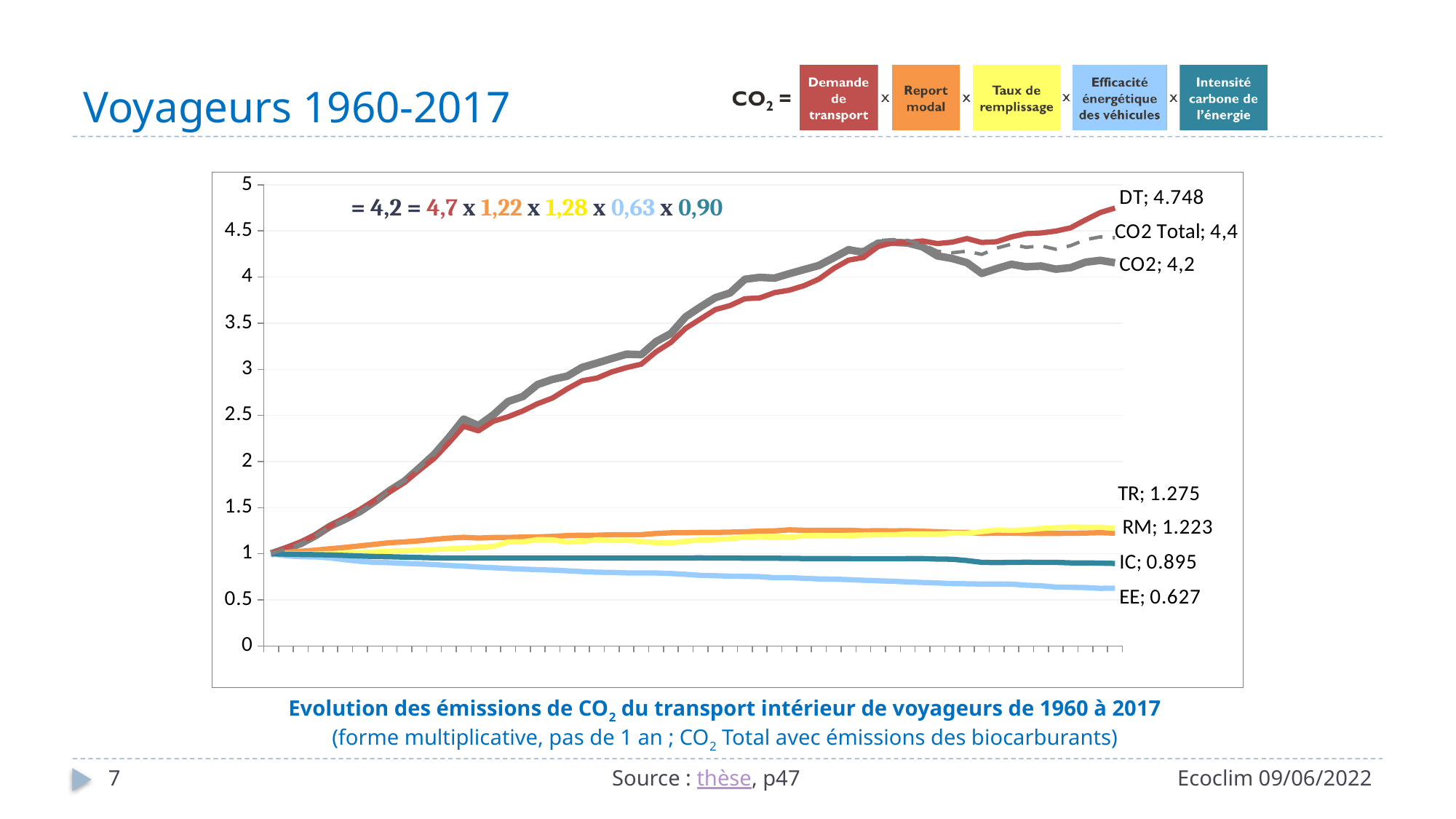
What is the final value shown for the IC series? 0.895 Which has a larger final value, IC or EE? IC Does the EE series rise or fall from 1960 to 2017? fall Is the final value of the CO2 series greater or less than 4? greater Which series has the lowest final value? EE What is the final value shown for the DT series? 4.748 What is the final value shown for the EE series? 0.627 What is the final value shown for the CO2 Total series? 4,4 Which series is drawn as a dashed line? CO2 Total Which series has the highest final value? DT What kind of chart is shown on the slide? line chart What is the difference between the final values of TR and RM? 0.052